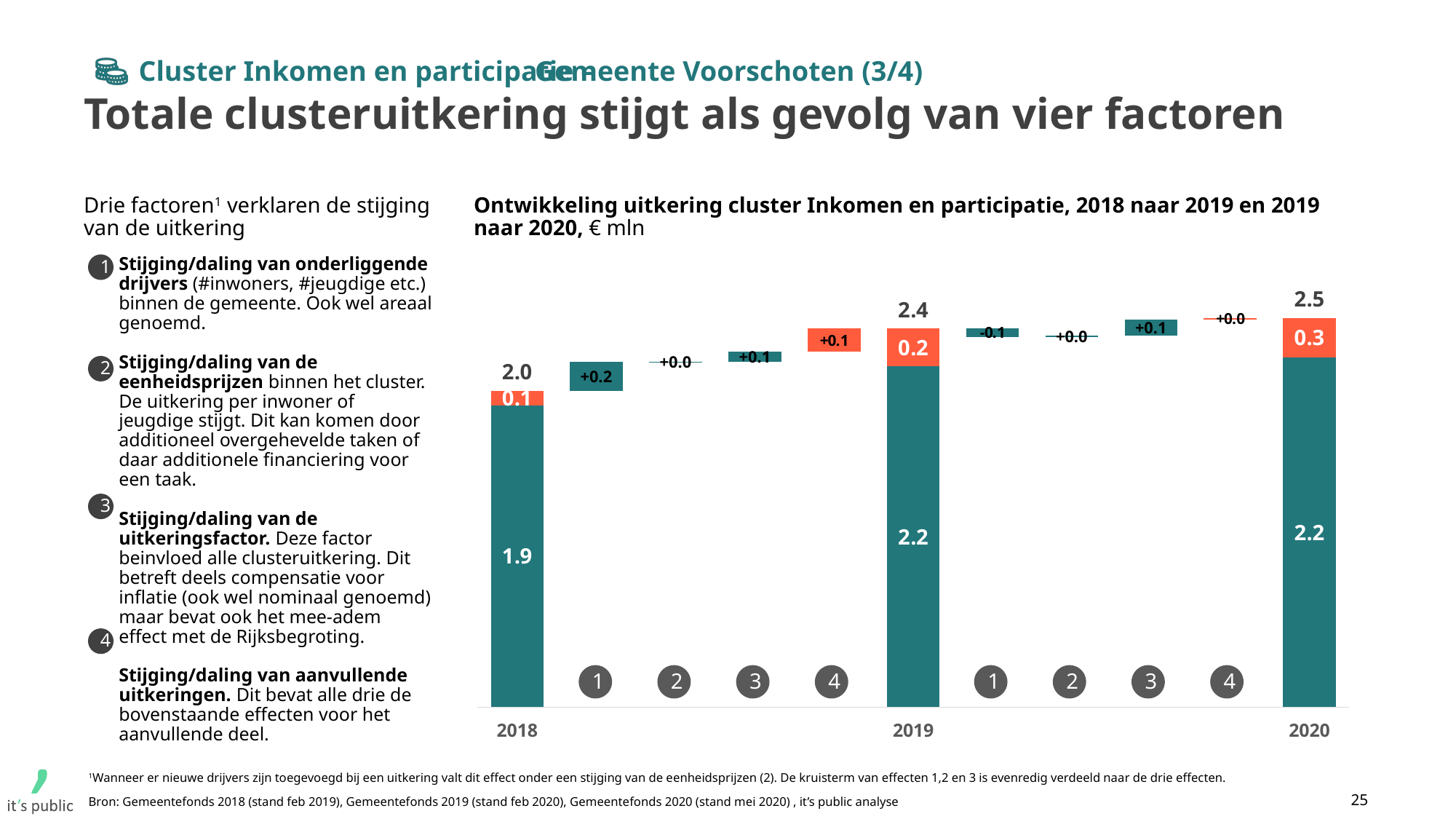
What is the value of factor 1 in the step from 2019 to 2020? -0.1 What is the difference between the total uitkering in 2020 and in 2018? 0.5 What is the total uitkering shown for 2020? 2.5 Which year has the lowest total uitkering? 2018 Which year has the highest total uitkering? 2020 Does the total uitkering rise or fall from 2018 to 2020? rise What is the value of factor 1 in the step from 2018 to 2019? +0.2 What is the value of the teal (bottom) segment of the 2018 bar? 1.9 What is the total uitkering shown for 2018? 2.0 In what unit are the values in the chart expressed? € mln What is the value of the orange (top) segment of the 2020 bar? 0.3 What is the total uitkering shown for 2019? 2.4